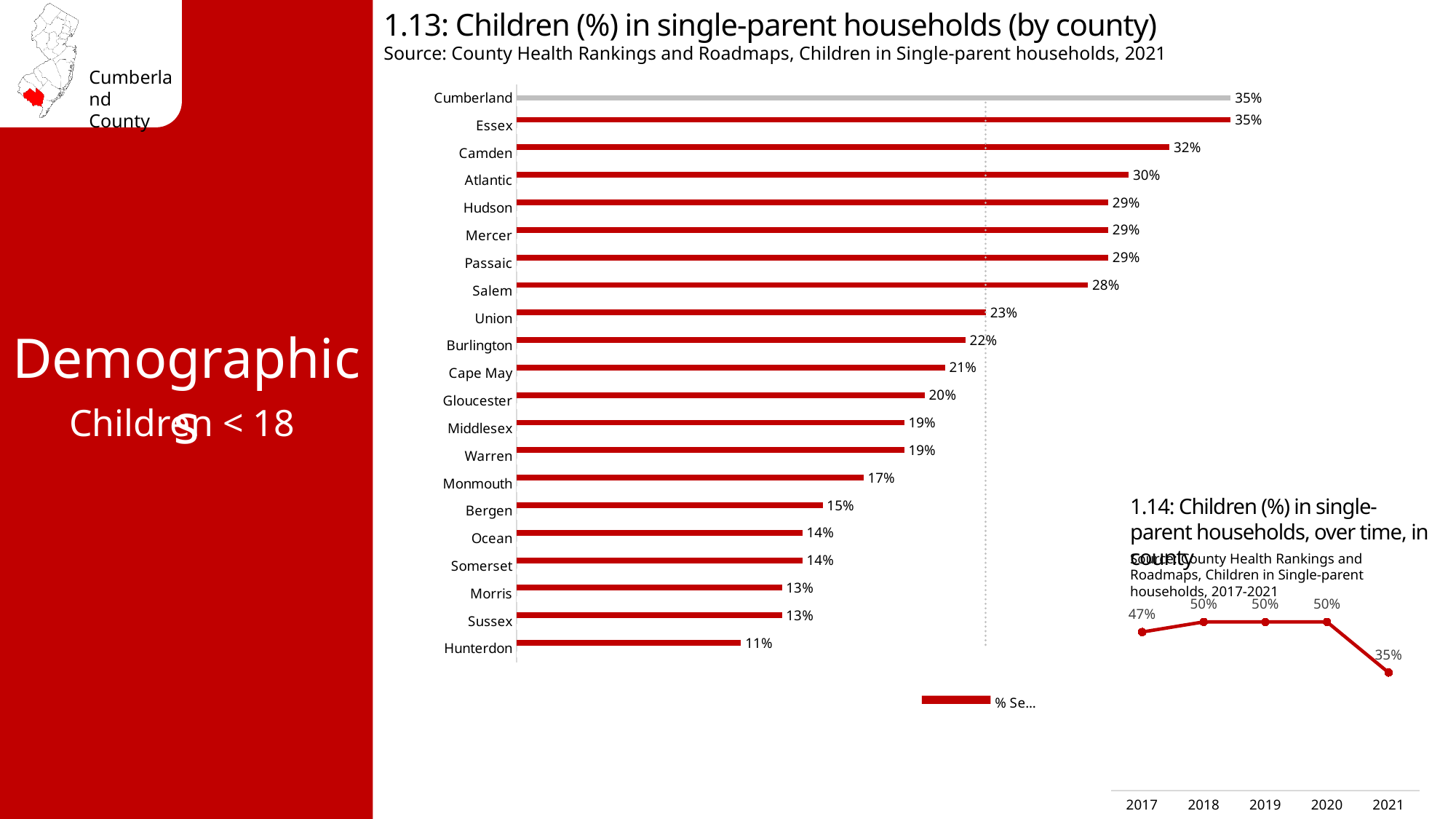
In chart 1.14, what is the difference between the 2020 and 2021 values? 15% In chart 1.14 (Children in single-parent households over time), what is the value for 2017? 47% What type of chart is chart 1.13? Bar chart In chart 1.13, how many counties are plotted? 21 In chart 1.13, what is the difference between the values for Atlantic and Gloucester? 10% In chart 1.13, which county has the lowest percentage of children in single-parent households? Hunterdon In chart 1.14, what is the value for 2021? 35% In chart 1.13, which has a higher value, Union or Monmouth? Union In chart 1.14, which year has the lowest value? 2021 In chart 1.13 (Children in single-parent households by county), what is the value for Camden? 32% In chart 1.13, what percentage is shown for Salem? 28% What type of chart is chart 1.14? Line chart